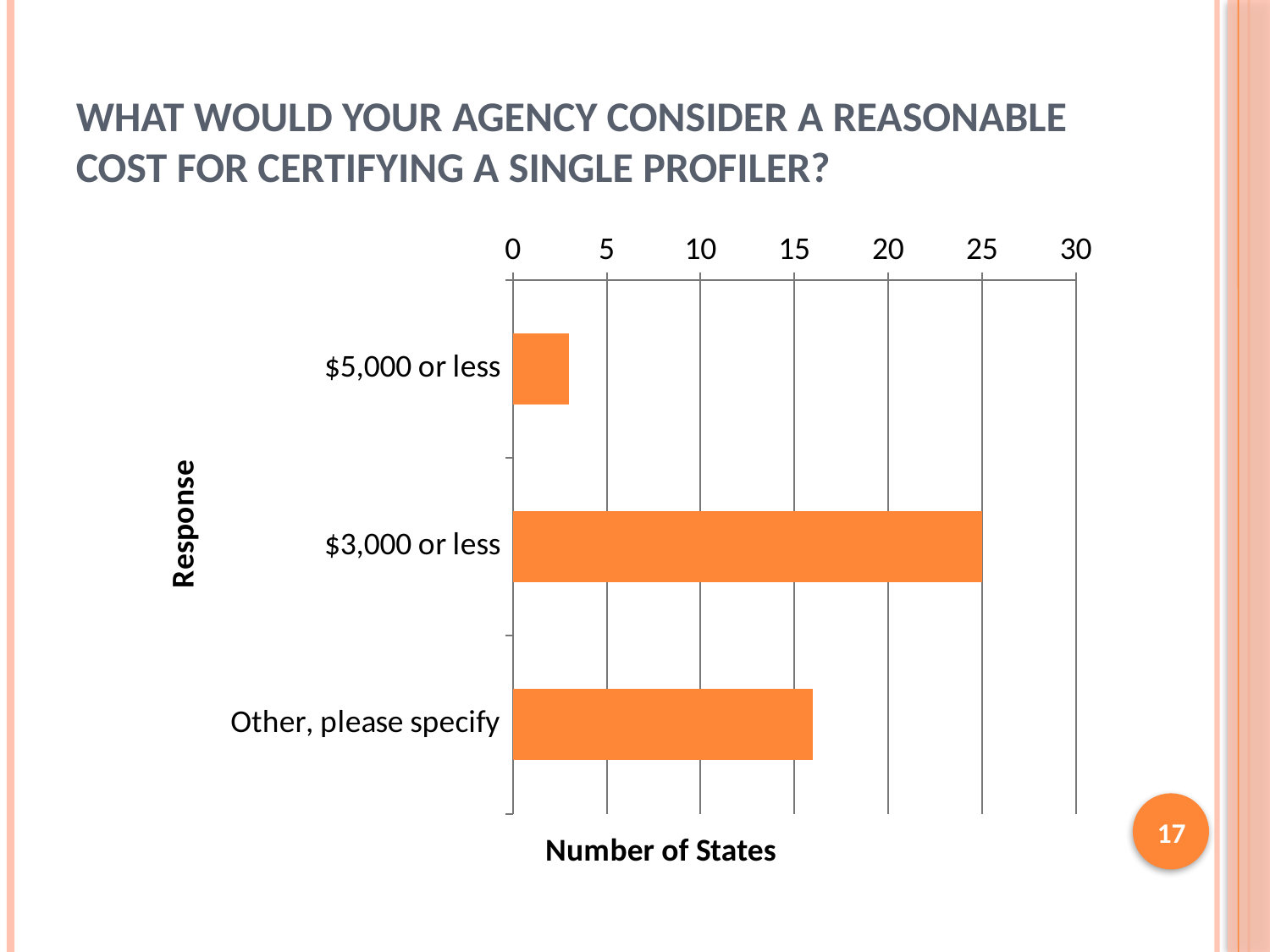
What is the title of the horizontal axis? Number of States What is the title of the vertical axis? Response How many response categories are plotted in the chart? 3 How many states chose "$3,000 or less"? 25 What kind of chart is shown on the slide? bar chart Is the number of states for "Other, please specify" greater or less than 20? less Which has more states: "Other, please specify" or "$5,000 or less"? Other, please specify Which response has the lowest number of states? $5,000 or less Which has more states: "$3,000 or less" or "Other, please specify"? $3,000 or less Is the number of states for "$5,000 or less" greater or less than 5? less Which response has the highest number of states? $3,000 or less Is the number of states for "Other, please specify" greater or less than 15? greater